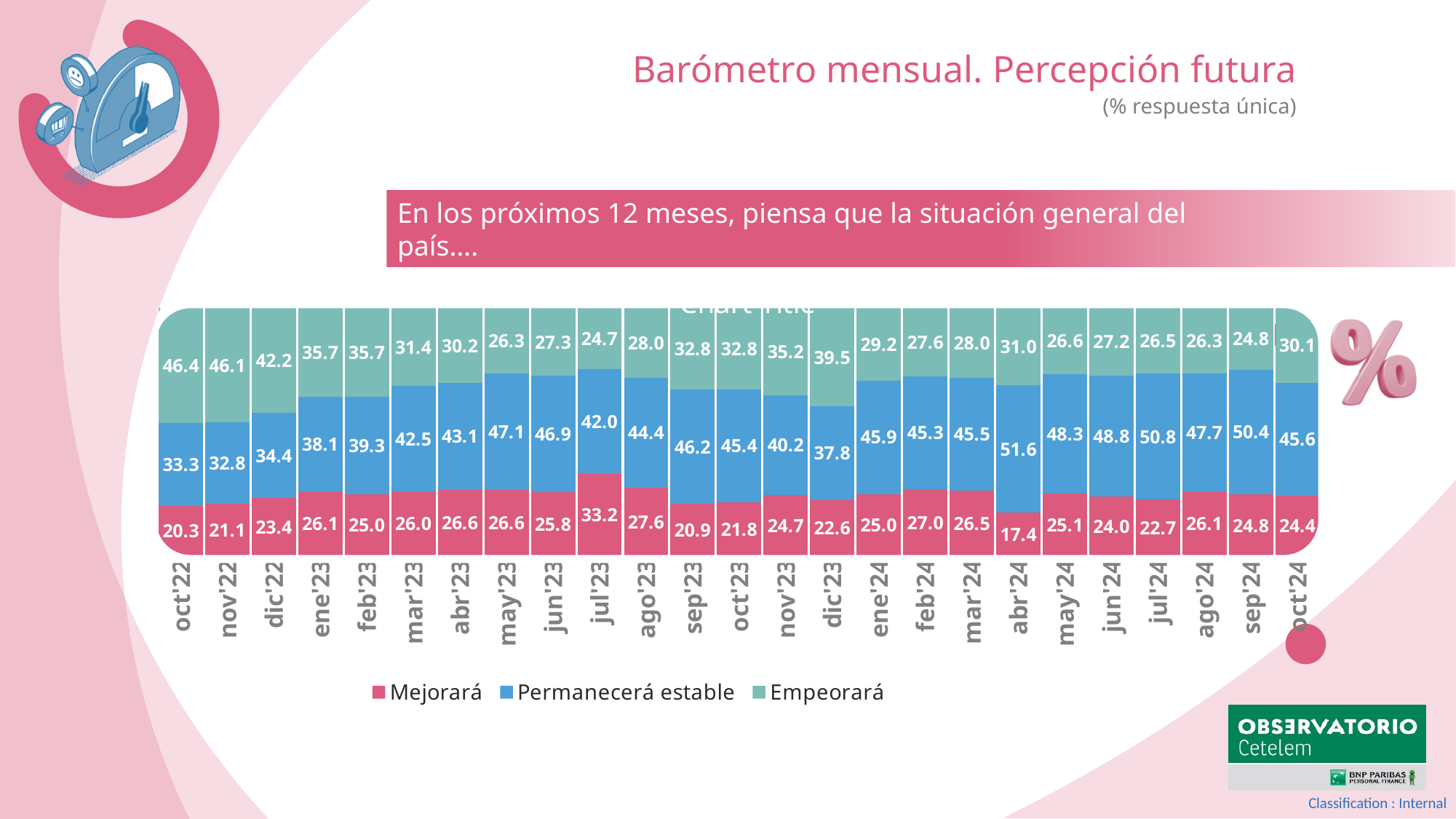
What is the value of 'Mejorará' for jul'23? 33.2 How many months (categories) are shown on the x axis? 25 In which month is 'Empeorará' highest? oct'22 In which month is 'Permanecerá estable' highest? abr'24 What is the value of 'Permanecerá estable' for oct'24? 45.6 What is the value of 'Empeorará' for dic'23? 39.5 What is the total of the stacked bar for oct'22? 100.0 What is the difference between the 'Empeorará' value for oct'22 and for oct'24? 16.3 How many series does the legend list? 3 Which is larger: 'Mejorará' for ene'24 or 'Mejorará' for feb'24? feb'24 What kind of chart is shown on the slide? stacked bar chart In which month is 'Mejorará' lowest? abr'24